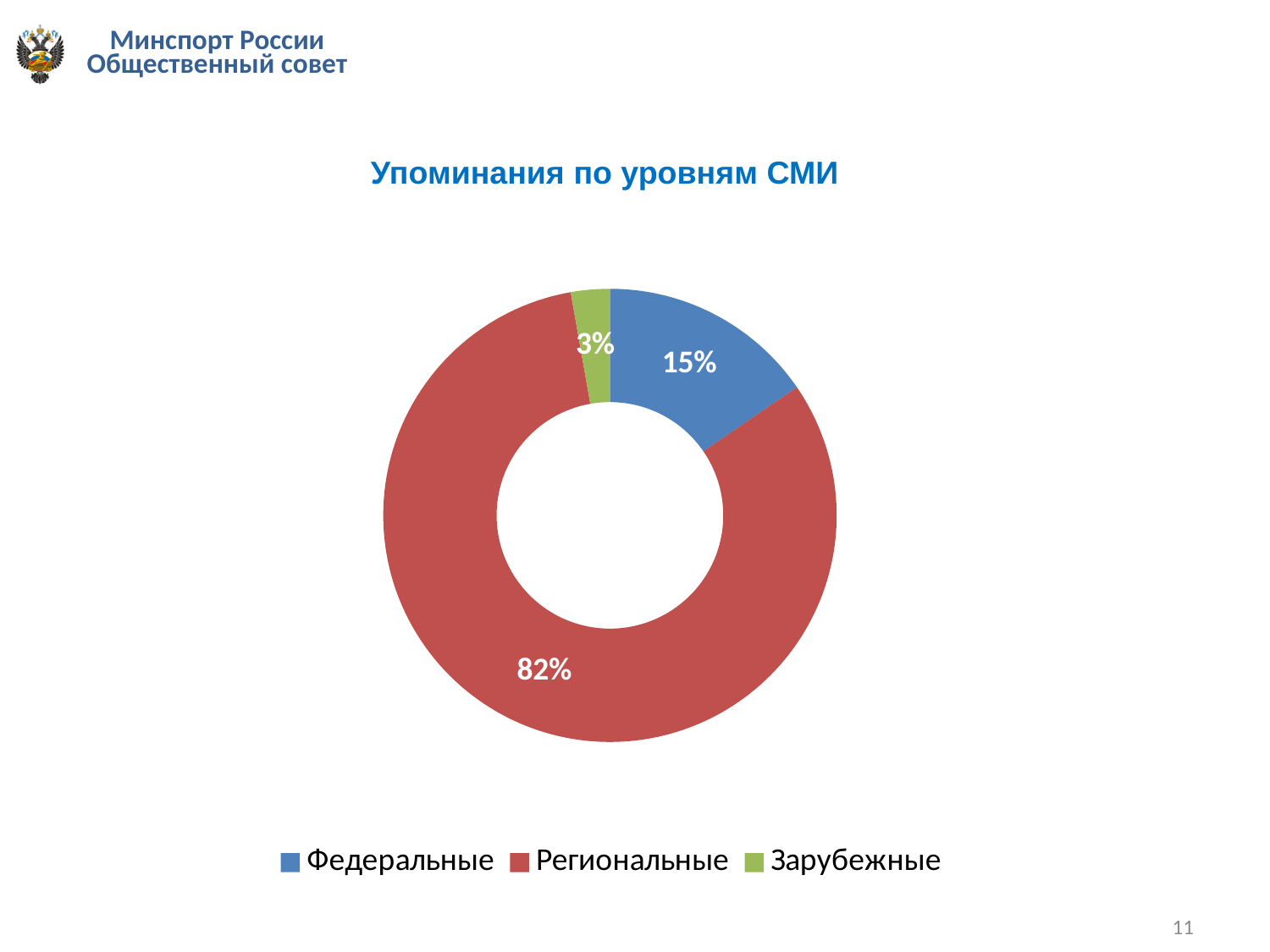
What share of mentions is for Зарубежные media? 3% What kind of chart is shown on the slide? Doughnut (pie) chart Which media level has the smallest share of mentions? Зарубежные What is the difference in percentage points between the Региональные and Федеральные shares? 67 What share of mentions is for Федеральные media? 15% Which colour represents Зарубежные in the chart? Green What is the title of the chart? Упоминания по уровням СМИ Which has a larger share: Федеральные or Зарубежные? Федеральные What is the difference in percentage points between the Федеральные and Зарубежные shares? 12 What share of mentions is for Региональные media? 82% Which media level has the largest share of mentions? Региональные How many categories does the chart show? 3